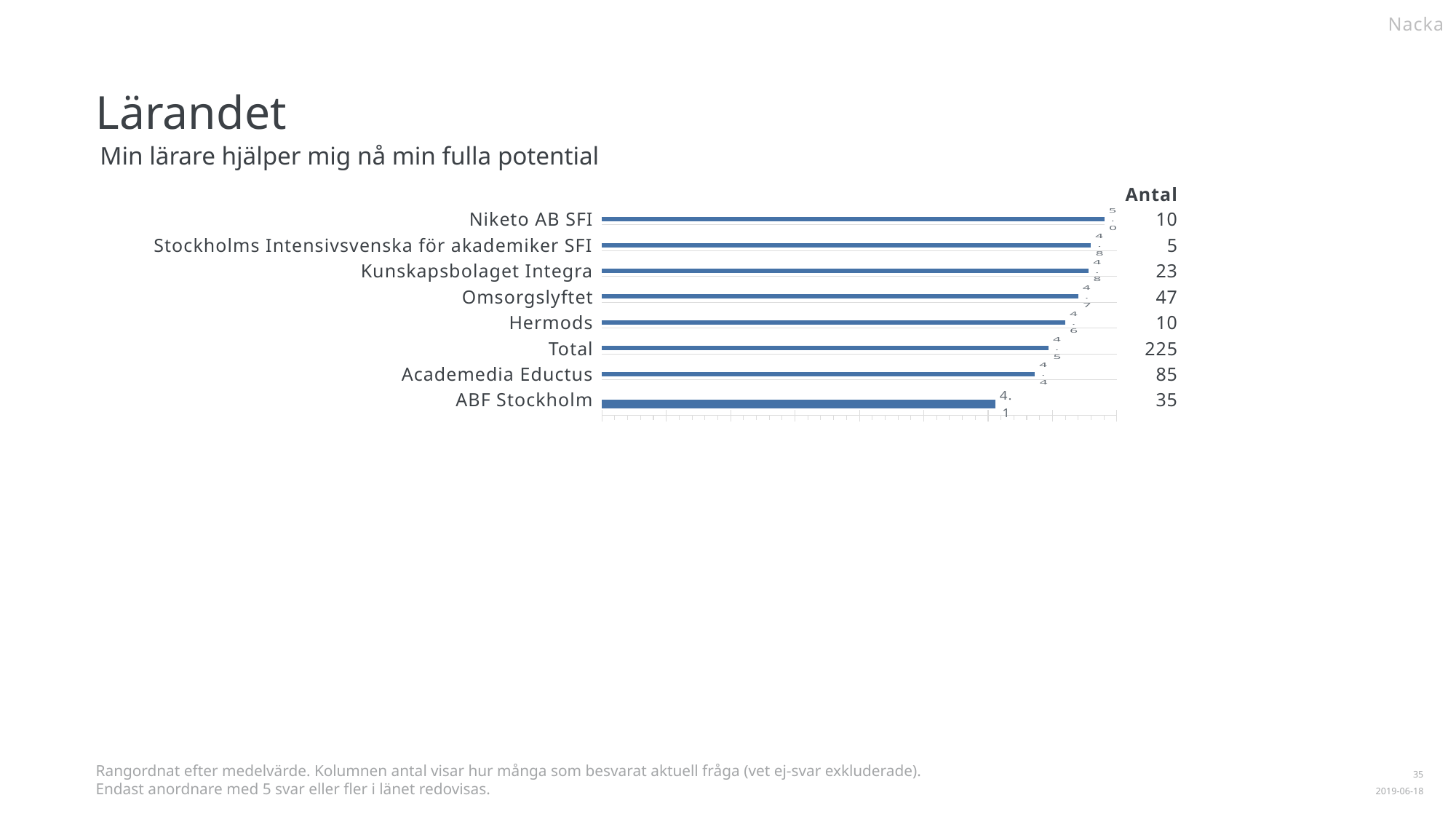
What is the value shown for ABF Stockholm? 4.1 According to the Antal column next to the chart, how many respondents are listed for Total? 225 Which category has the highest value in the chart? Niketo AB SFI How many categories (bars) does the chart show? 8 What is the difference between the values for Niketo AB SFI and ABF Stockholm? 0.9 Which category has the lowest value in the chart? ABF Stockholm What is the value shown for Total? 4.5 What is the value shown for Hermods? 4.6 Which has a larger value, Omsorgslyftet or Academedia Eductus? Omsorgslyftet What is the subtitle (question text) shown above the chart? Min lärare hjälper mig nå min fulla potential What is the value shown for Niketo AB SFI? 5.0 What kind of chart is shown on the slide? bar chart